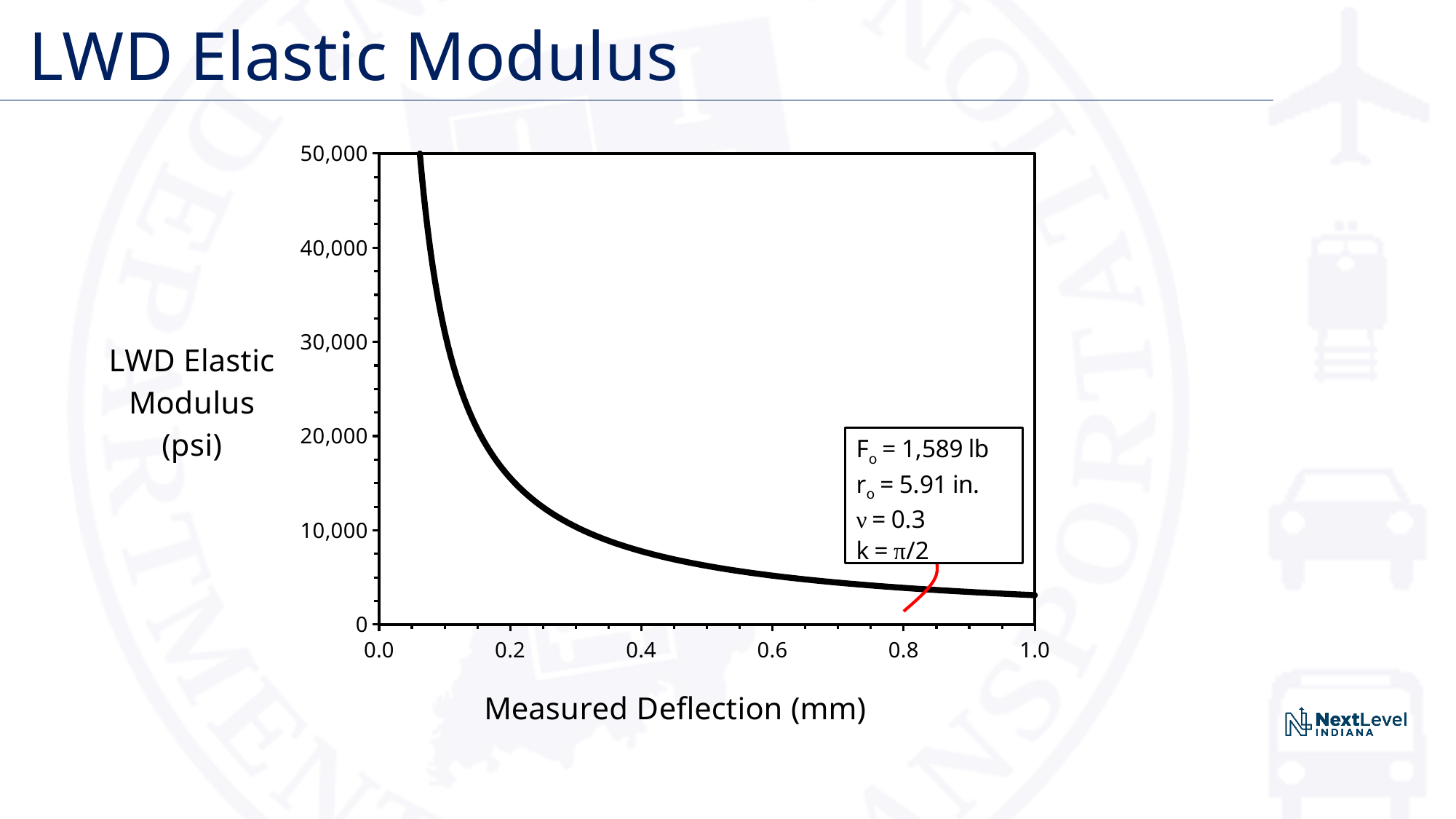
Is the LWD Elastic Modulus at a measured deflection of 0.2 mm greater or less than 10,000 psi? greater What value of F_o is given in the annotation box on the chart? 1,589 lb Which has the larger LWD Elastic Modulus: a measured deflection of 0.2 mm or 0.8 mm? 0.2 mm What is the maximum value shown on the y axis of the chart? 50,000 What kind of chart is shown on the slide? line chart Is the LWD Elastic Modulus at a measured deflection of 0.6 mm greater or less than 10,000 psi? less Is the LWD Elastic Modulus at a measured deflection of 0.4 mm greater or less than 10,000 psi? less Does the LWD Elastic Modulus rise or fall as Measured Deflection increases from 0.0 to 1.0 mm? fall